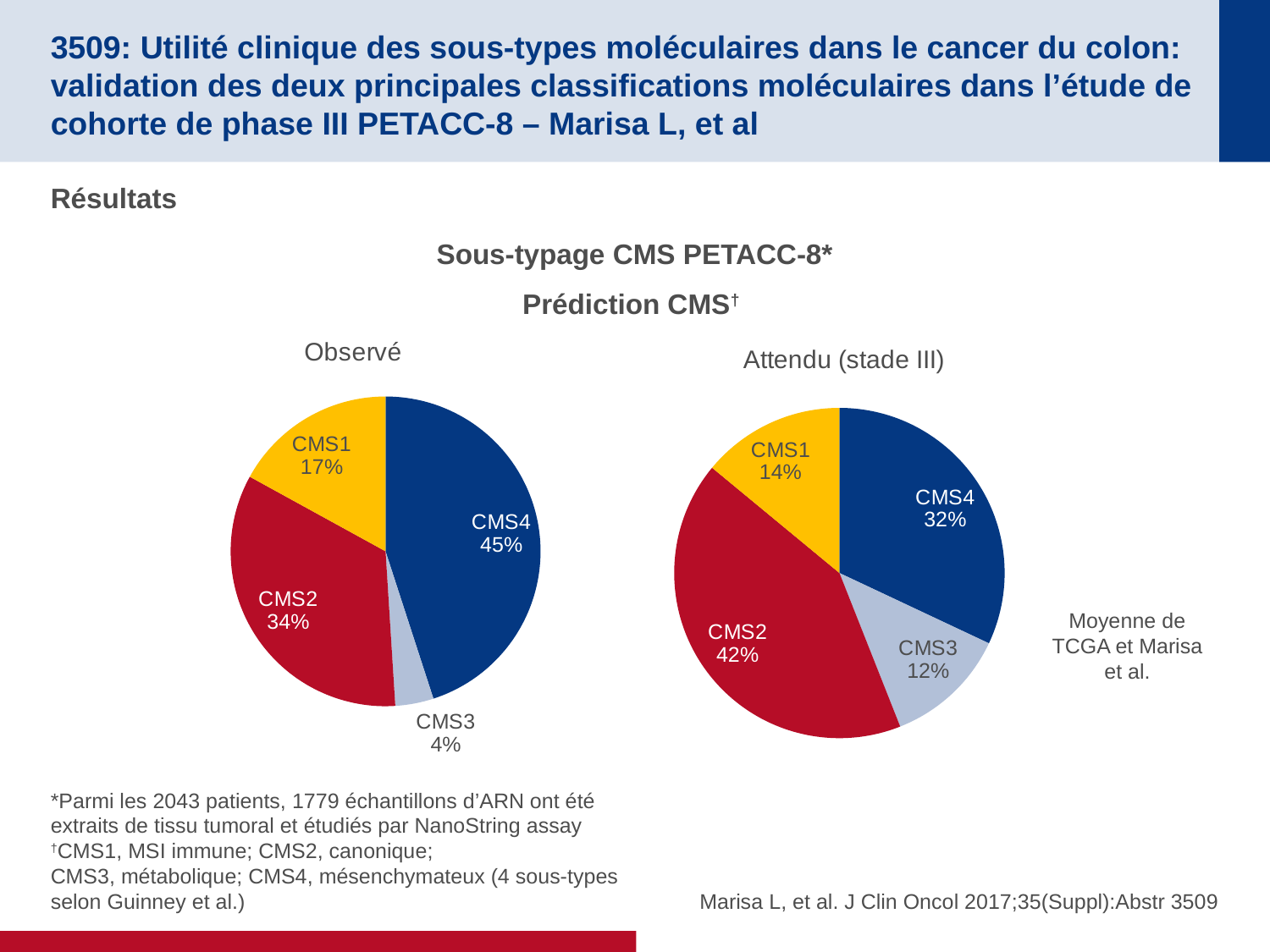
In the 'Attendu (stade III)' pie chart, what is the share for CMS1? 14% In the 'Attendu (stade III)' pie chart, what is the difference between the CMS2 and CMS4 shares? 10% What type of chart is used for 'Attendu (stade III)'? Pie chart Which is larger: the CMS1 share in the 'Observé' chart or the CMS1 share in the 'Attendu (stade III)' chart? Observé In the 'Attendu (stade III)' pie chart, what is the share for CMS2? 42% In the 'Observé' pie chart, which subtype has the largest slice? CMS4 In the 'Observé' pie chart, what is the difference between the CMS4 and CMS2 shares? 11% In the 'Observé' pie chart, what colour is the CMS2 slice? Red In the 'Observé' pie chart, what is the share for CMS3? 4% In the 'Observé' pie chart, what is the share for CMS4? 45% In the 'Attendu (stade III)' pie chart, which subtype has the smallest slice? CMS3 How many slices does the 'Observé' pie chart have? 4